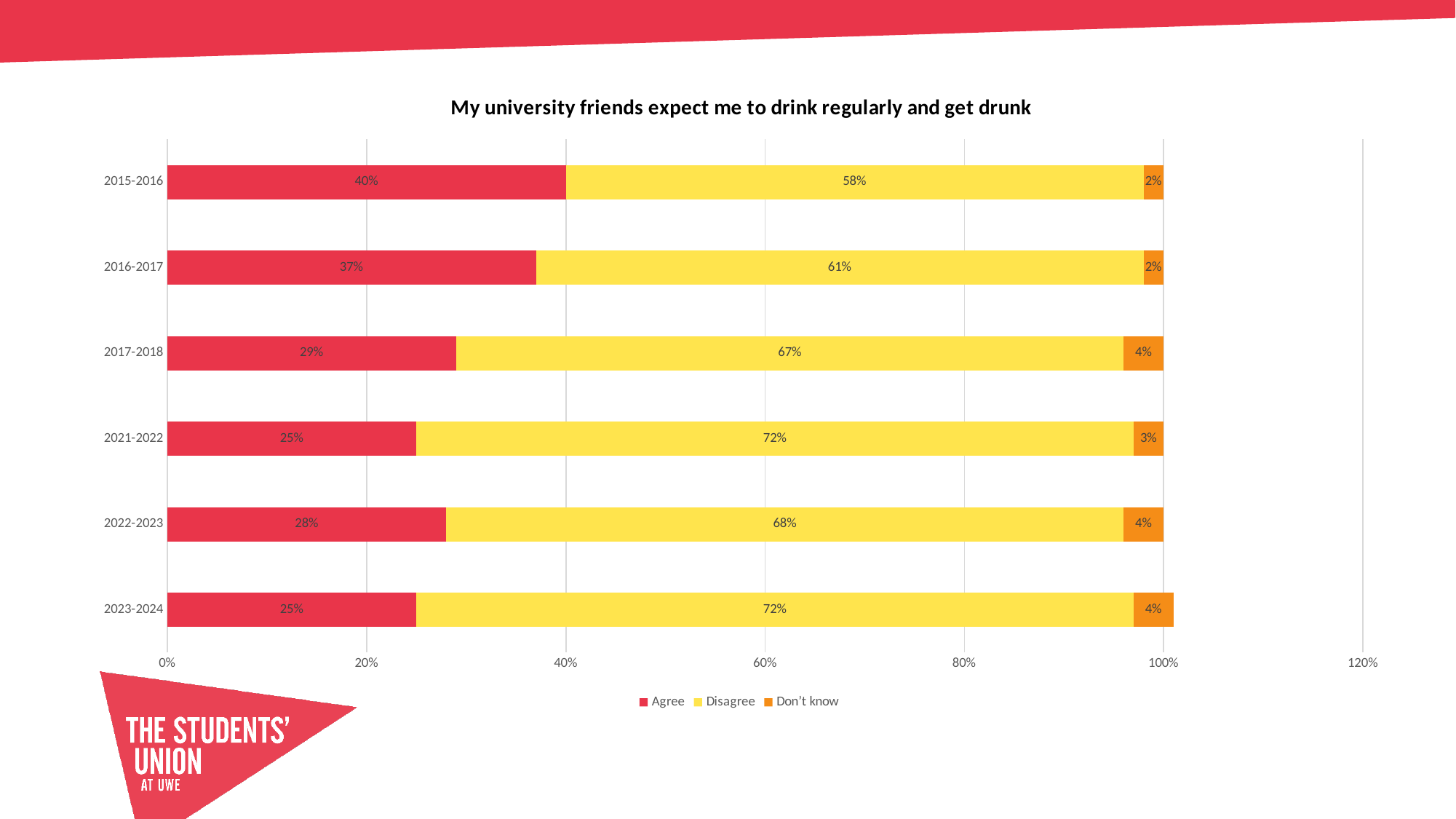
What is the total of the stacked bar for 2023-2024? 101% What is the difference between the Agree values for 2015-2016 and 2023-2024? 15% What is the 'Don't know' value for 2017-2018? 4% What percentage agreed in 2015-2016? 40% What is the title of the chart? My university friends expect me to drink regularly and get drunk How many year categories are shown on the chart? 6 What kind of chart is shown? Stacked bar chart How many series does the legend list? 3 Is the Agree value larger in 2016-2017 or in 2022-2023? 2016-2017 Which year has the lowest Disagree percentage? 2015-2016 Which year has the highest Agree percentage? 2015-2016 What percentage disagreed in 2021-2022? 72%